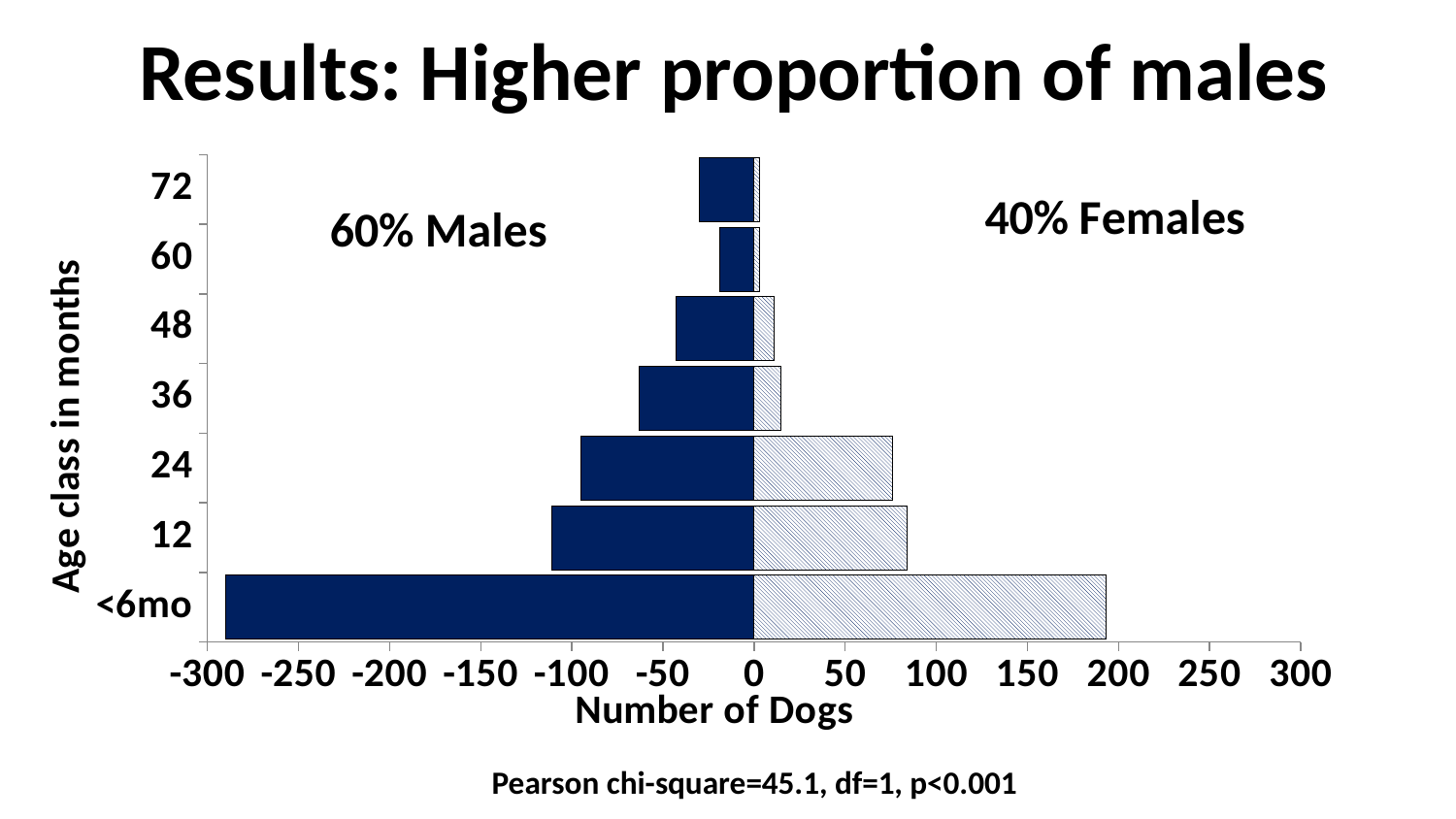
Does the male bar for the <6mo age class extend past the -250 tick on the x axis? yes Which age class has the largest number of female dogs? <6mo Is the number of female dogs in the 24-month age class greater or less than 50? greater What percentage of the dogs are males according to the label on the chart? 60% Males What kind of chart is shown on the slide? bar chart Which age class has the largest number of male dogs? <6mo Is the number of female dogs in the 36-month age class greater or less than 50? less Do the numbers of dogs generally rise or fall as the age class increases from <6mo to 72 months? fall How many age classes are shown on the y axis? 7 Which age class has more male dogs, 36 months or 48 months? 36 Which age class has the smallest number of male dogs? 60